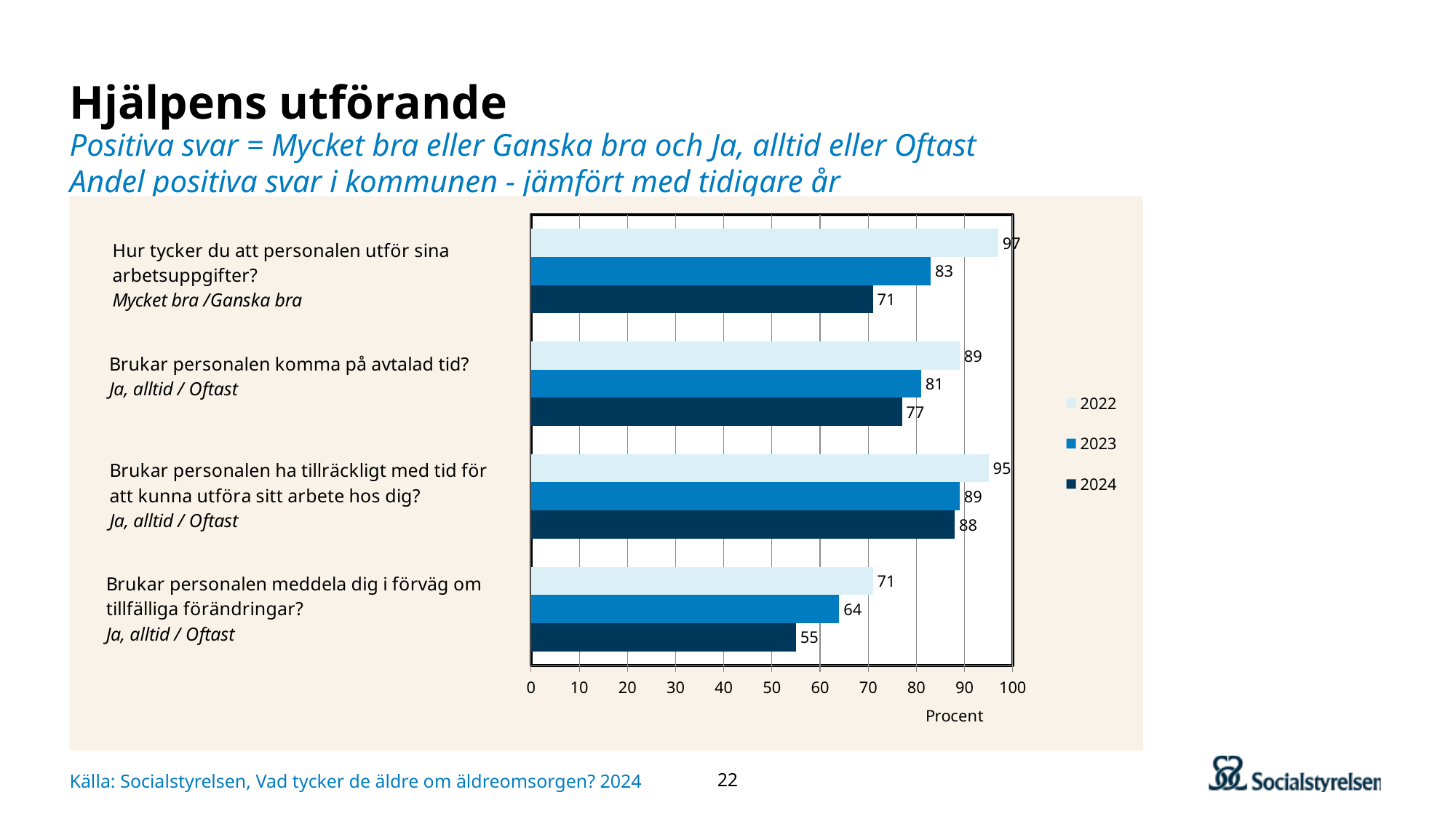
What is the 2023 value for "Brukar personalen meddela dig i förväg om tillfälliga förändringar?"? 64 What is the difference between the 2022 and 2024 values for "Hur tycker du att personalen utför sina arbetsuppgifter?"? 26 What is the 2024 value for "Brukar personalen komma på avtalad tid?"? 77 What kind of chart is shown on the slide? Bar chart For "Brukar personalen komma på avtalad tid?", which year has the larger value, 2023 or 2024? 2023 Which question has the highest 2024 value? Brukar personalen ha tillräckligt med tid för att kunna utföra sitt arbete hos dig? What is the 2022 value for "Hur tycker du att personalen utför sina arbetsuppgifter?"? 97 For "Brukar personalen meddela dig i förväg om tillfälliga förändringar?", do the values rise or fall from 2022 to 2024? Fall What is the label on the horizontal axis of the chart? Procent Which question has the lowest 2024 value? Brukar personalen meddela dig i förväg om tillfälliga förändringar? How many questions (categories) are shown in the chart? 4 How many series does the legend list? 3